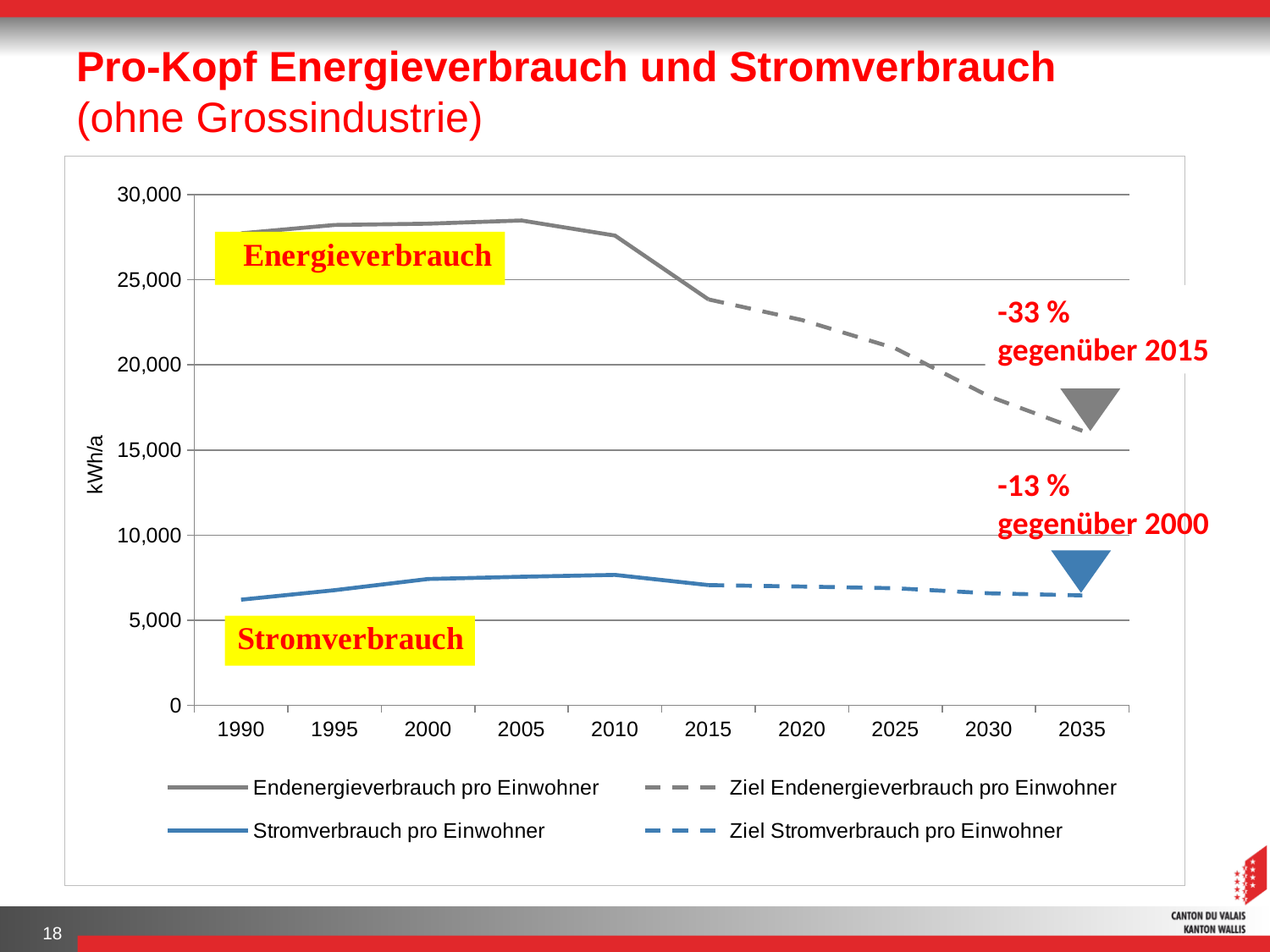
What unit is shown on the y-axis? kWh/a What percentage reduction is annotated for the energy consumption target compared with 2015? -33 % Does the Ziel Endenergieverbrauch pro Einwohner line rise or fall between 2015 and 2035? fall Does the Stromverbrauch pro Einwohner line rise or fall between 1990 and 2010? rise Is the value of Ziel Endenergieverbrauch pro Einwohner in 2035 greater or less than 15,000? greater Is the value of Endenergieverbrauch pro Einwohner in 2005 greater or less than 25,000? greater Is the value of Stromverbrauch pro Einwohner in 2010 greater or less than 10,000? less In 2000, which is larger: Endenergieverbrauch pro Einwohner or Stromverbrauch pro Einwohner? Endenergieverbrauch pro Einwohner How many series does the legend list? 4 What kind of chart is shown on the slide? line chart